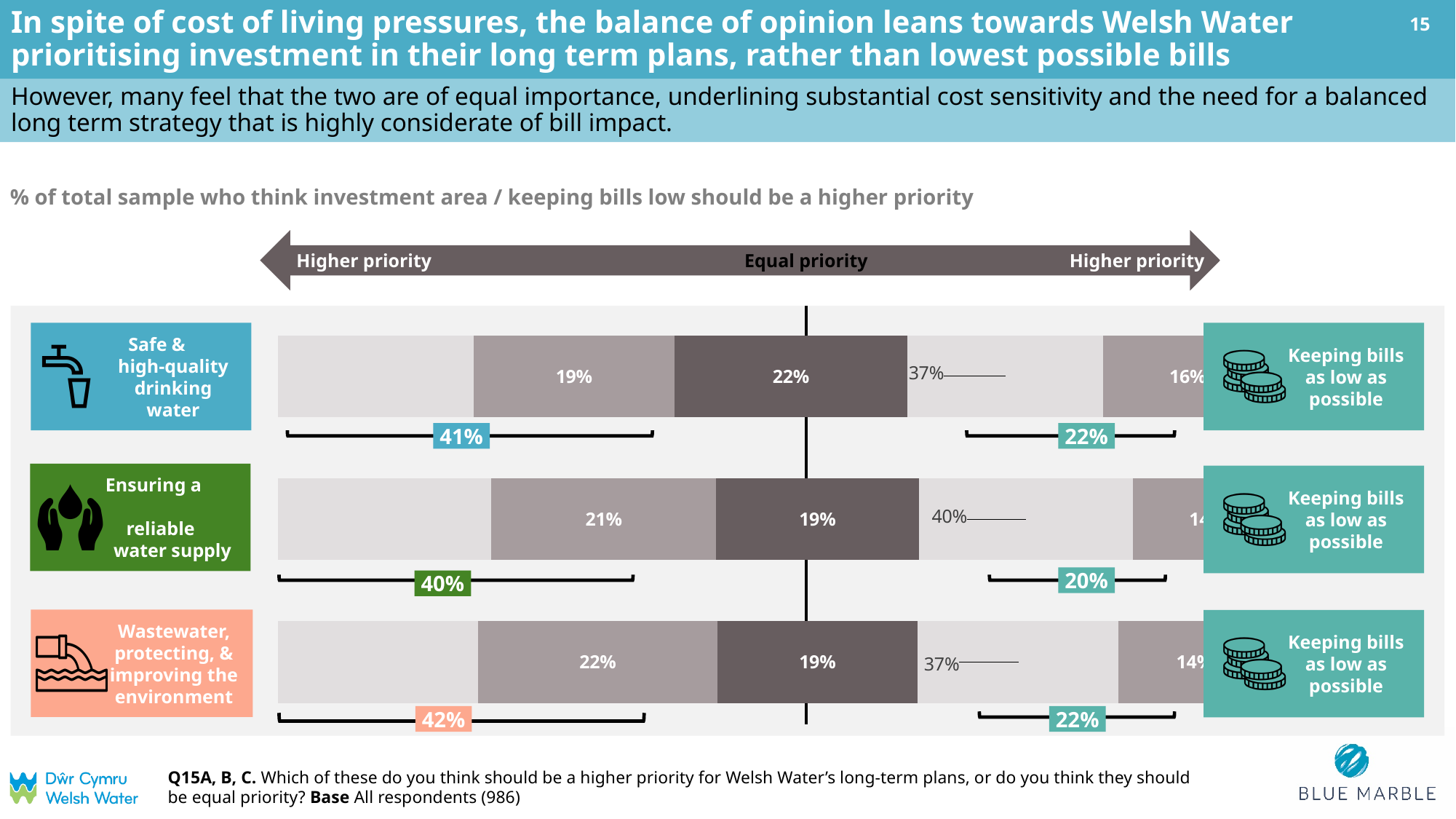
What percentage of respondents think ensuring a reliable water supply and keeping bills low are of equal priority? 19% Which investment area has the highest net percentage of respondents saying it should be a higher priority than keeping bills low? Wastewater, protecting, & improving the environment What kind of chart is used on this slide? Stacked bar chart (diverging horizontal bars) How many investment areas are shown in the chart? 3 What percentage of respondents think keeping bills low should be a higher priority than ensuring a reliable water supply (the bracketed net figure)? 20% Which investment area has the lowest net percentage of respondents saying it should be a higher priority than keeping bills low? Ensuring a reliable water supply What percentage of respondents think safe & high-quality drinking water and keeping bills low are of equal priority? 22% What label appears at the centre of the arrow above the chart? Equal priority What percentage of respondents think safe & high-quality drinking water should be a higher priority than keeping bills low (the bracketed net figure)? 41% What percentage of respondents think wastewater, protecting & improving the environment should be a higher priority than keeping bills low (the bracketed net figure)? 42% What is the difference between the net percentage prioritising wastewater/environment (42%) and the net percentage prioritising keeping bills low over it (22%)? 20 percentage points For safe & high-quality drinking water, which is larger: the net share prioritising the investment area (41%) or the net share prioritising keeping bills low (22%)? The net share prioritising the investment area (41%)